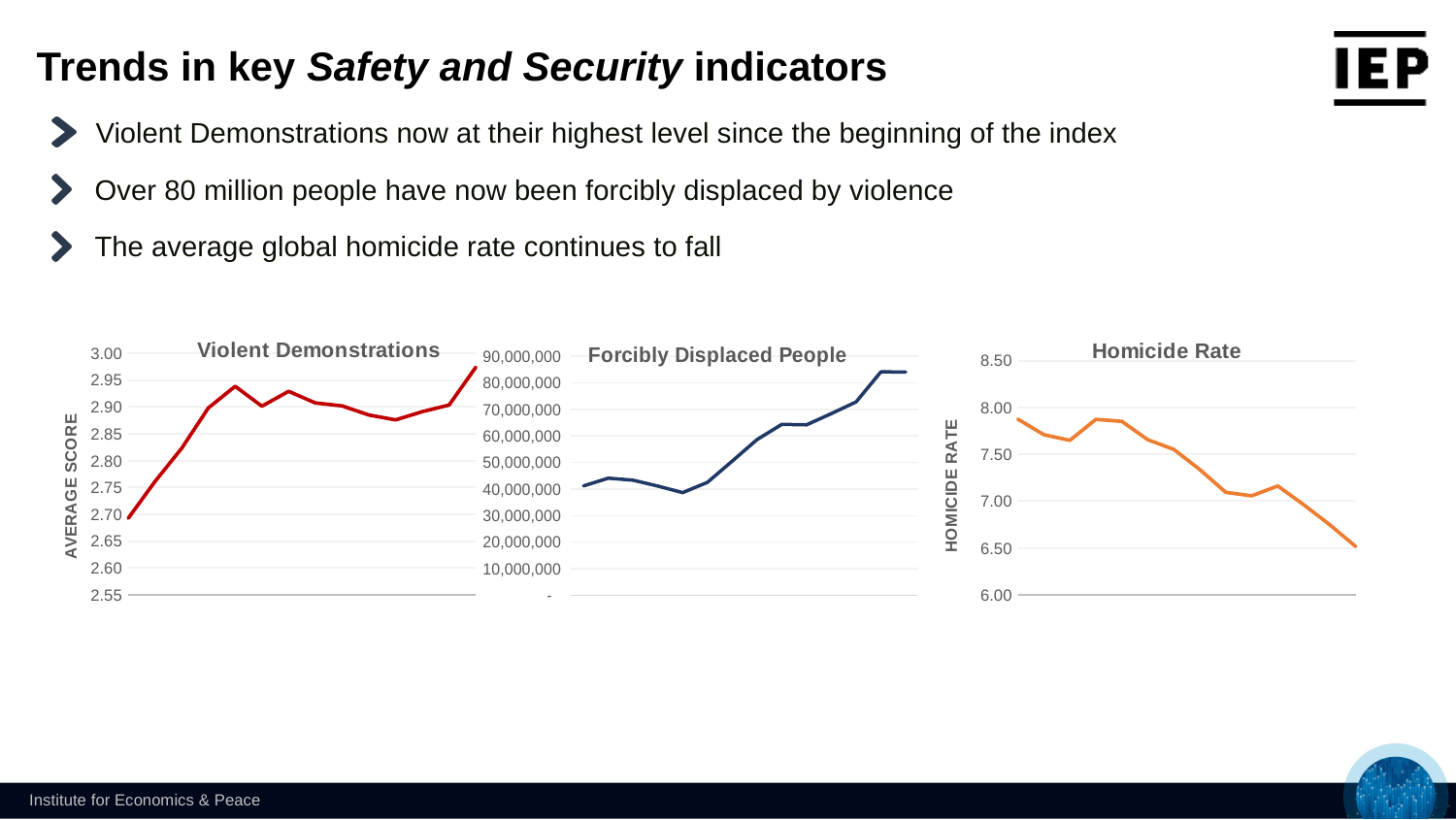
What is the y-axis title of the Violent Demonstrations chart? AVERAGE SCORE In the Violent Demonstrations chart, is the last plotted value greater or less than 2.95? greater In the Forcibly Displaced People chart, is the first plotted value greater or less than 50,000,000? less In the Homicide Rate chart, is the first plotted value greater or less than 7.50? greater What kind of chart is the Violent Demonstrations chart? line chart In the Violent Demonstrations chart, do the values overall rise or fall from left to right? rise In the Homicide Rate chart, do the values overall rise or fall from left to right? fall How many charts are shown on the slide? 3 In the Forcibly Displaced People chart, do the values overall rise or fall from left to right? rise